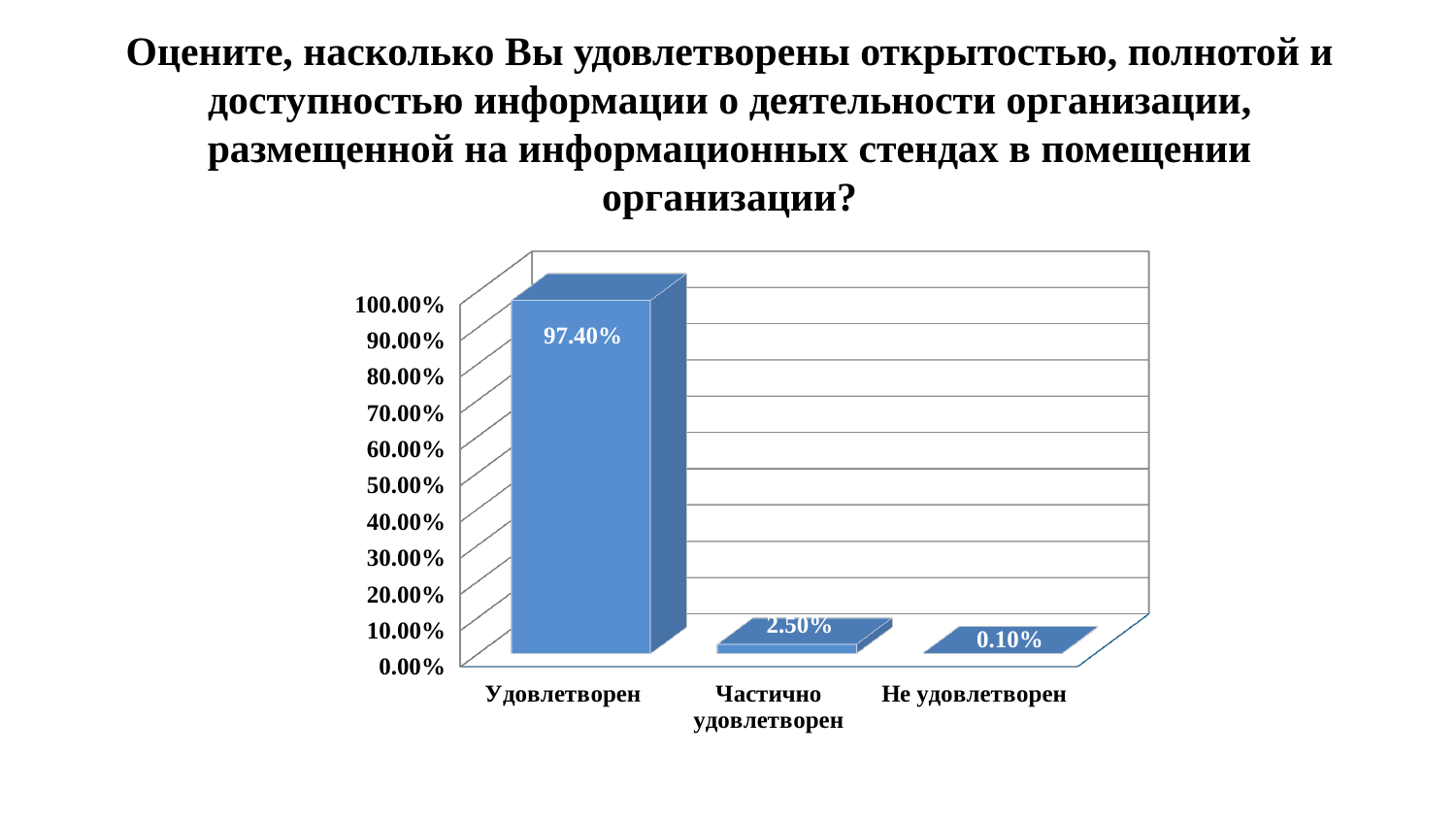
Is the value for Удовлетворен greater or less than 90.00%? greater Which category has the lowest value? Не удовлетворен Do the values rise or fall from left to right along the x axis? fall What is the difference between the values for Удовлетворен and Частично удовлетворен? 94.90% What is the value for Частично удовлетворен? 2.50% What is the value for Удовлетворен? 97.40% What kind of chart is shown on the slide? bar chart How many categories are shown on the x axis? 3 What is the difference between the values for Частично удовлетворен and Не удовлетворен? 2.40% What is the value for Не удовлетворен? 0.10% Which category has the highest value? Удовлетворен Which is larger, the value for Частично удовлетворен or the value for Не удовлетворен? Частично удовлетворен